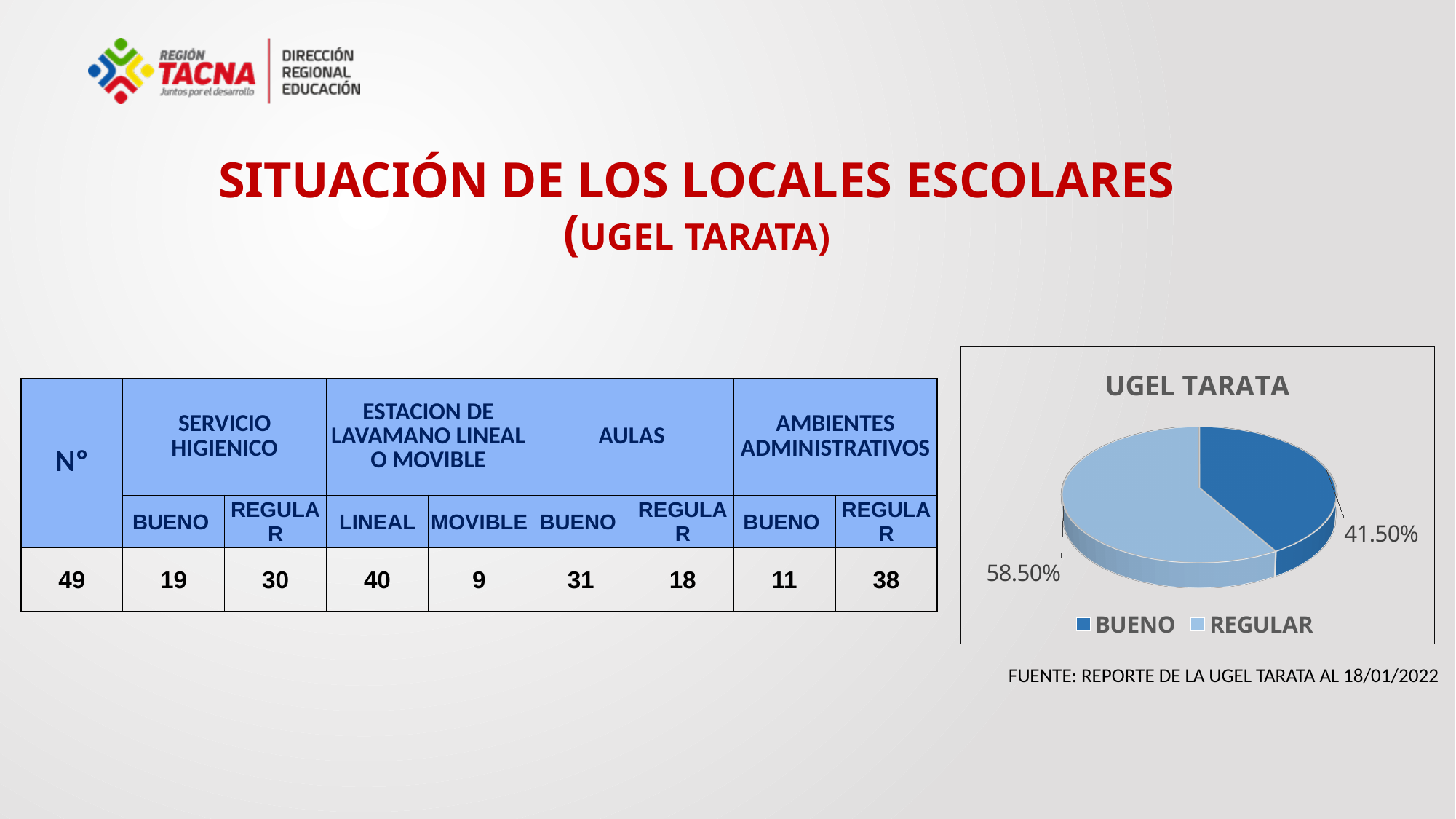
Is the value for BUENO in the pie chart greater or less than 50%? less Which legend entry is shown in the darker blue colour? BUENO How many slices does the pie chart have? 2 Which slice of the pie chart is the largest? REGULAR What percentage does the REGULAR slice represent in the pie chart? 58.50% What percentage does the BUENO slice represent in the pie chart? 41.50% Which slice of the pie chart is the smallest? BUENO What is the title of the chart? UGEL TARATA What type of chart is shown on the slide? pie chart What is the difference in percentage points between the REGULAR and BUENO slices? 17 percentage points How many entries does the chart legend list? 2 Which is larger in the pie chart, BUENO or REGULAR? REGULAR